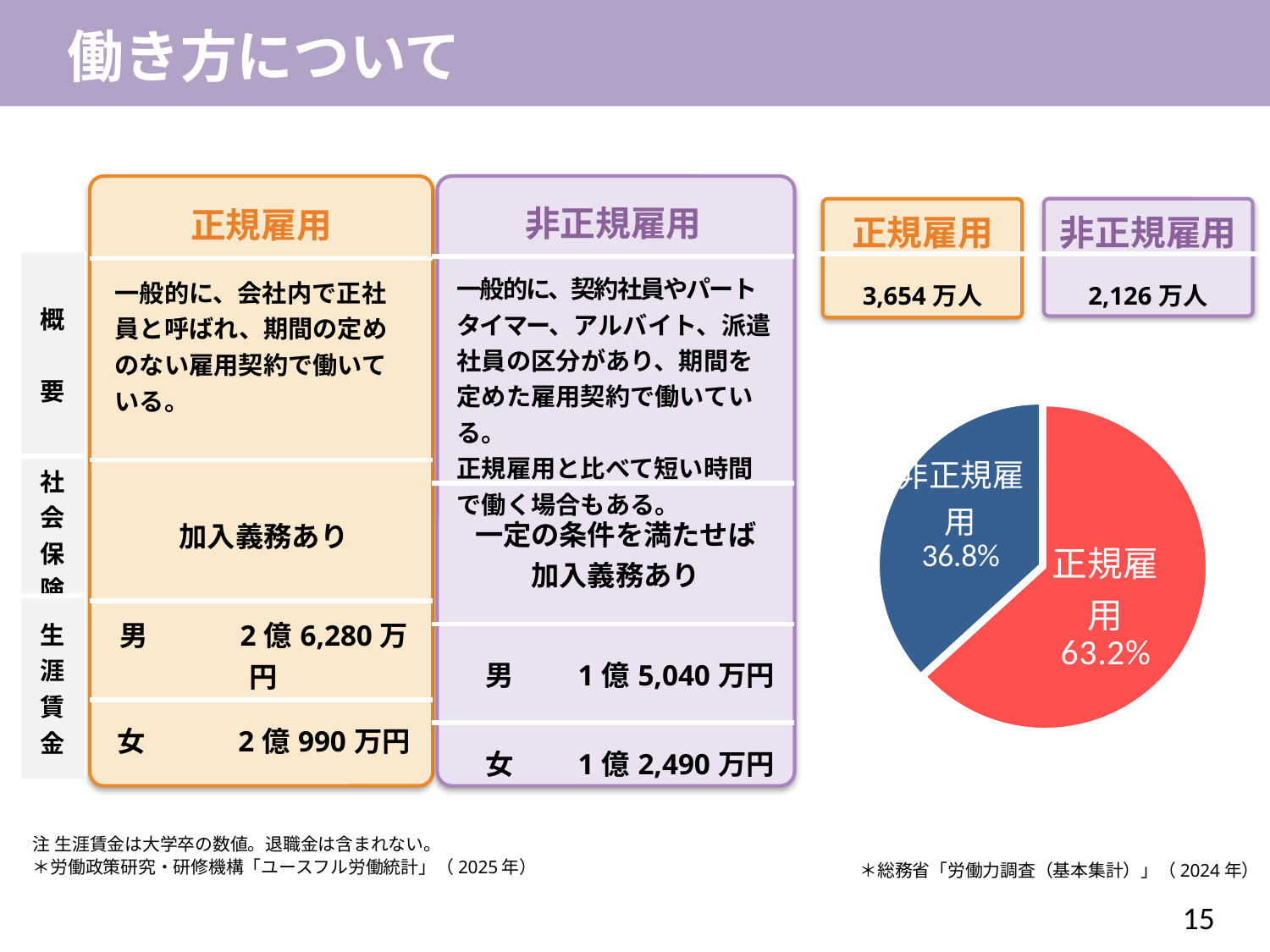
What kind of chart is shown on the slide? Pie chart What colour is the 正規雇用 slice in the pie chart? Red Which slice of the pie chart is the smallest? 非正規雇用 What colour is the 非正規雇用 slice in the pie chart? Blue By how many percentage points does the 正規雇用 slice exceed the 非正規雇用 slice in the pie chart? 26.4 percentage points Is the share for 非正規雇用 in the pie chart greater or less than 50%? less What share of the pie chart does 非正規雇用 represent? 36.8% Which slice of the pie chart is the largest? 正規雇用 How many slices does the pie chart have? 2 What share of the pie chart does 正規雇用 represent? 63.2% In the pie chart, which is larger, 正規雇用 or 非正規雇用? 正規雇用